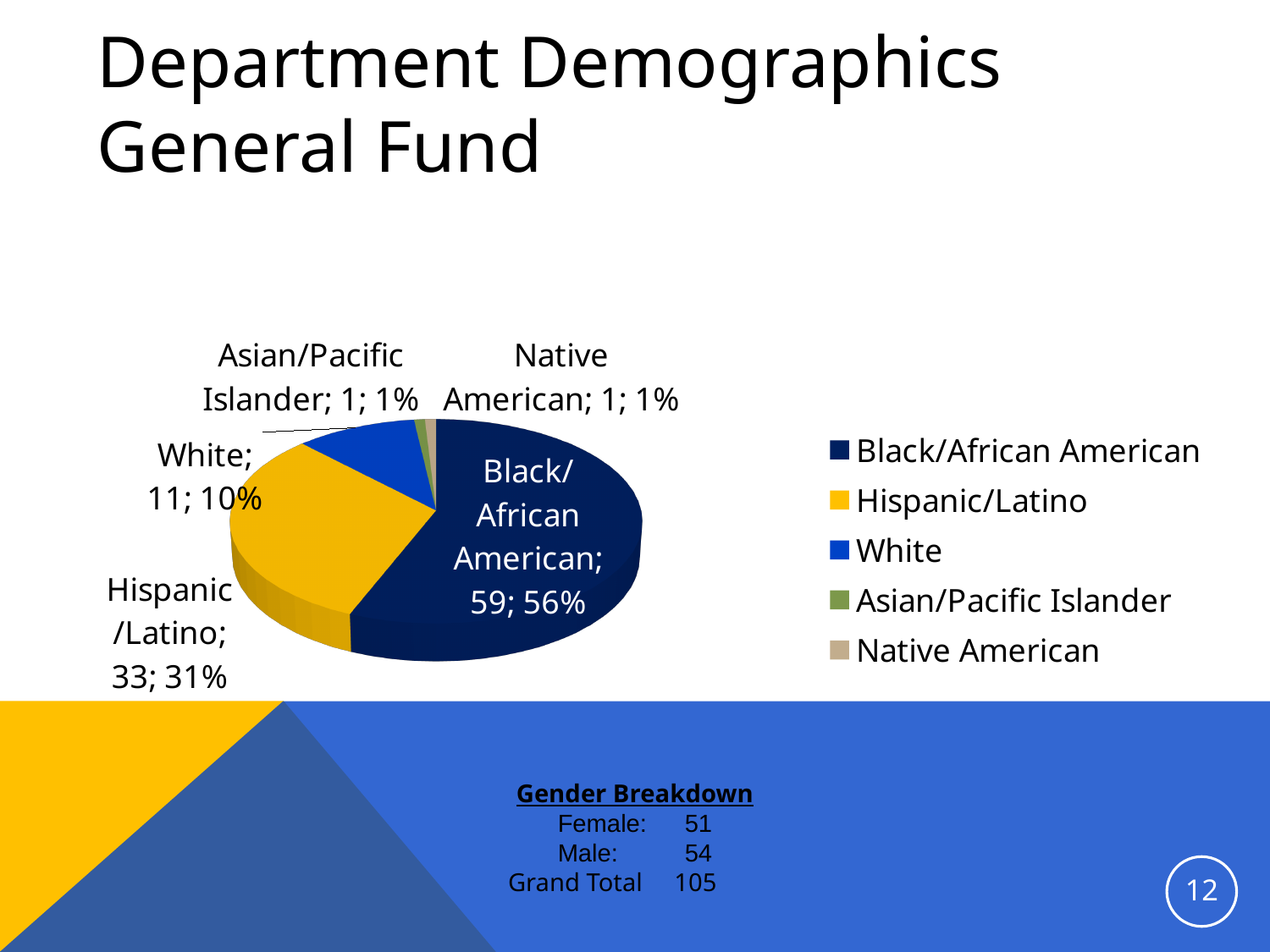
How many categories does the pie chart show? 5 What kind of chart is shown on the slide? pie chart Which category has the largest slice of the pie? Black/African American Which is larger, the value for Hispanic/Latino or the value for White? Hispanic/Latino What is the value for White in the pie chart? 11 What is the value for Hispanic/Latino in the pie chart? 33 What share of the pie does Hispanic/Latino represent? 31% What share of the pie does White represent? 10% What is the difference between the values for Black/African American and Hispanic/Latino? 26 What is the value for Black/African American in the pie chart? 59 Which colour represents Hispanic/Latino in the legend? yellow What share of the pie does Black/African American represent? 56%